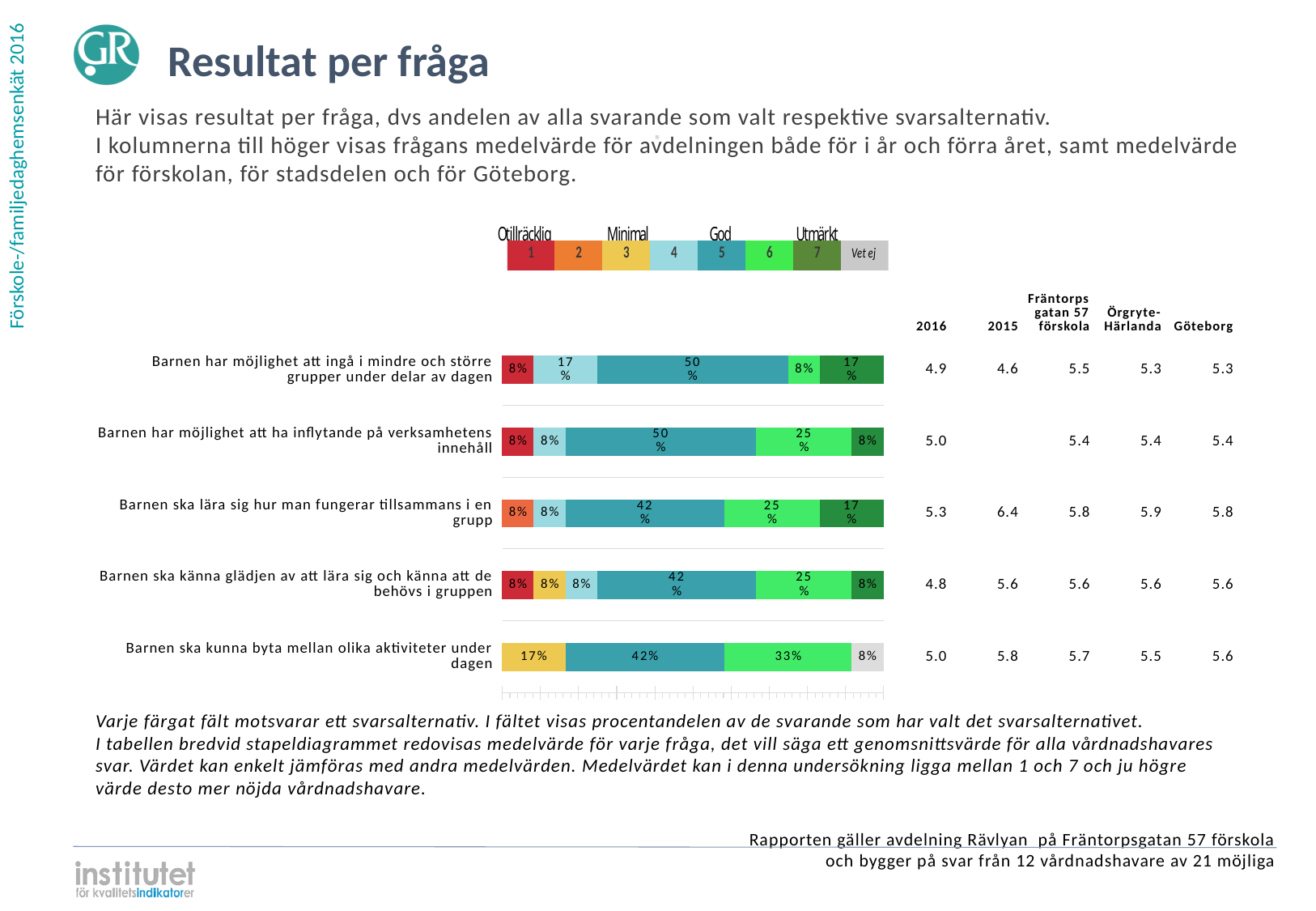
What is the combined share of options 6 and 7 for 'Barnen har möjlighet att ingå i mindre och större grupper under delar av dagen'? 25% What percentage answered 'Vet ej' (grey) for 'Barnen ska kunna byta mellan olika aktiviteter under dagen'? 8% How many response options does the legend above the chart list, including 'Vet ej'? 8 What is the difference between the option 6 share (25%) and the option 7 share (8%) for 'Barnen har möjlighet att ha inflytande på verksamhetens innehåll'? 17 percentage points What is the 2016 mean value shown next to the bar for 'Barnen ska lära sig hur man fungerar tillsammans i en grupp'? 5.3 How many questions (categories) are plotted as bars in the chart? 5 What kind of chart is shown on the slide? Stacked bar chart Which question has the largest share of respondents choosing option 5 (teal)? Barnen har möjlighet att ingå i mindre och större grupper under delar av dagen and Barnen har möjlighet att ha inflytande på verksamhetens innehåll (both 50%) For 'Barnen ska känna glädjen av att lära sig och känna att de behövs i gruppen', which is larger: the share choosing option 5 (teal) or option 6 (bright green)? Option 5 (42%) What percentage chose option 7 (dark green) for 'Barnen ska lära sig hur man fungerar tillsammans i en grupp'? 17% What percentage chose option 6 (bright green) for 'Barnen ska kunna byta mellan olika aktiviteter under dagen'? 33% What percentage of respondents chose option 5 (God, teal) for 'Barnen har möjlighet att ingå i mindre och större grupper under delar av dagen'? 50%